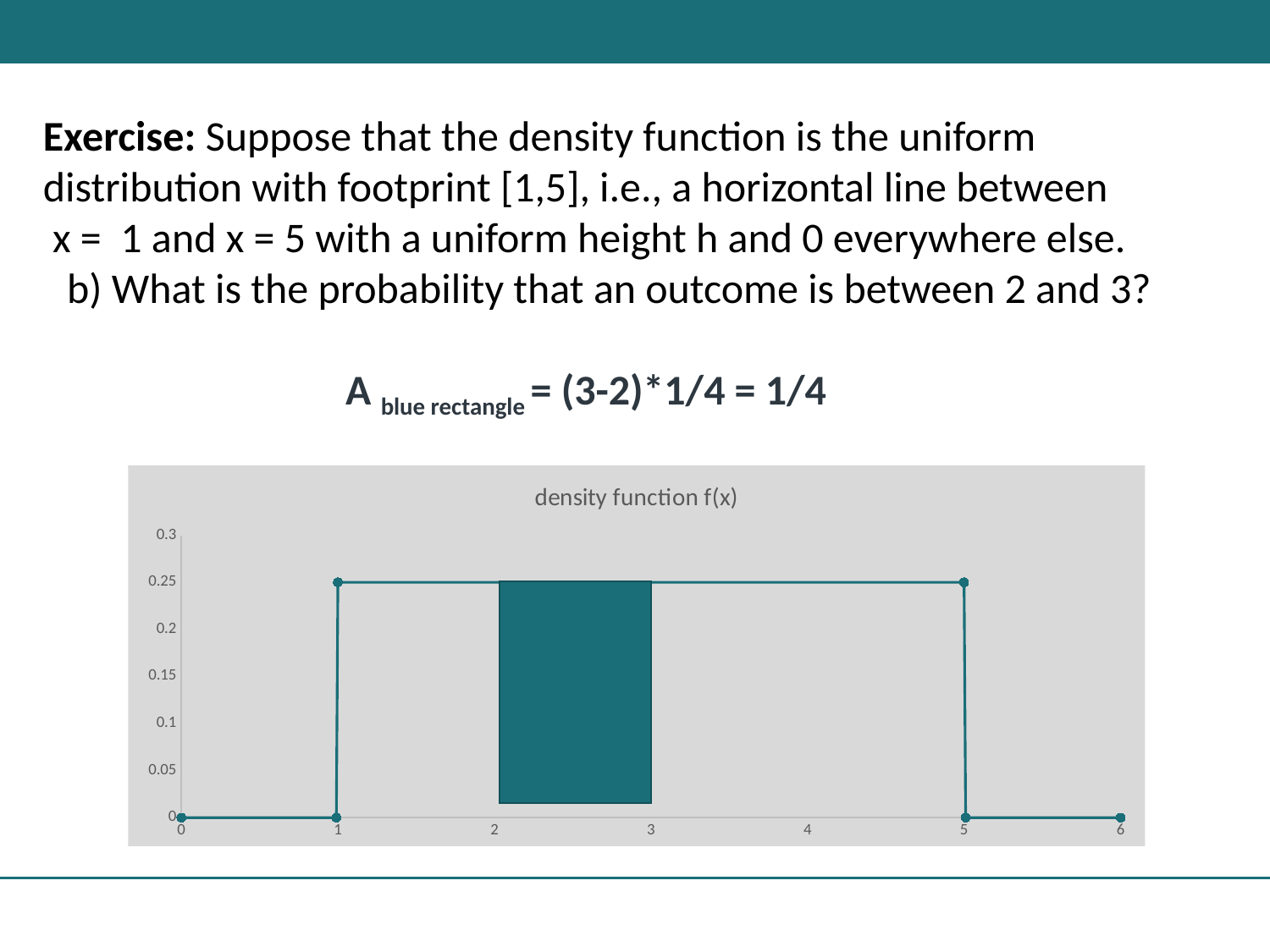
Between x = 1 and x = 5, does the plotted line rise, fall, or stay flat? stay flat What is the highest value labelled on the y axis? 0.3 Which is larger, the density function value at x = 2 or at x = 6? x = 2 What is the value of the density function at x = 0? 0 How many tick labels are shown on the x axis? 7 Is the value of the density function at x = 4 greater or less than 0.2? greater What is the value of the density function at x = 6? 0 What is the height of the shaded rectangle on the y axis? 0.25 What is the value of the density function at x = 3? 0.25 Between which two x values is the shaded rectangle drawn? 2 and 3 What is the title of the chart? density function f(x) What kind of chart is shown on the slide? line chart